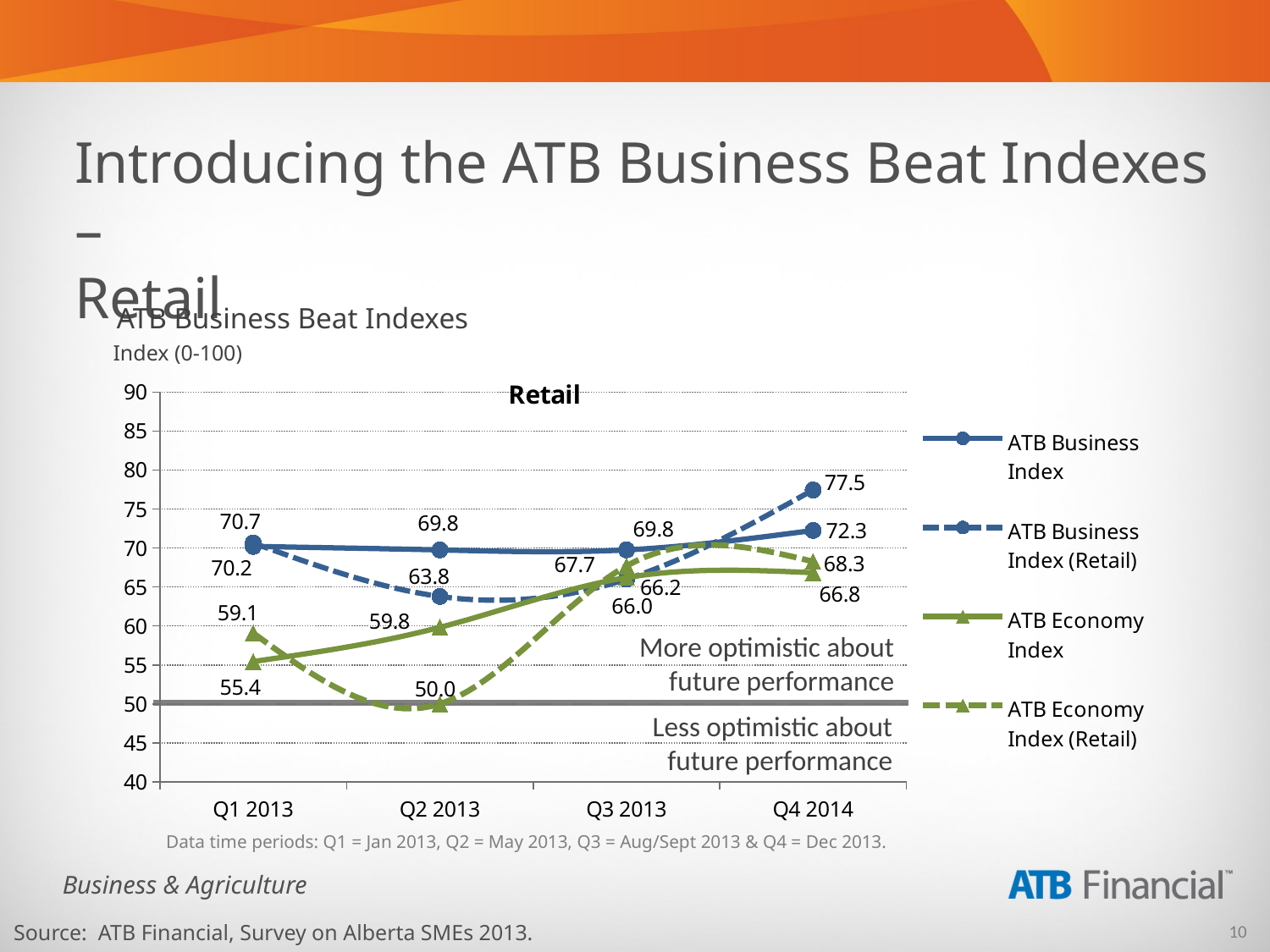
How many series does the legend list? 4 How many time periods are shown on the x axis? 4 In Q2 2013, which is larger: the ATB Economy Index or the ATB Economy Index (Retail)? ATB Economy Index What is the value of the ATB Business Index (Retail) in Q4 2014? 77.5 What is the value of the ATB Business Index (Retail) in Q2 2013? 63.8 What is the value of the ATB Economy Index (Retail) in Q4 2014? 68.3 In which period is the ATB Business Index (Retail) highest? Q4 2014 What kind of chart is shown on the slide? Line chart In which period is the ATB Economy Index (Retail) lowest? Q2 2013 Does the ATB Business Index (Retail) rise or fall from Q3 2013 to Q4 2014? Rise In Q4 2014, how much higher is the ATB Business Index (Retail) than the ATB Business Index? 5.2 What is the value of the ATB Economy Index (Retail) in Q2 2013? 50.0